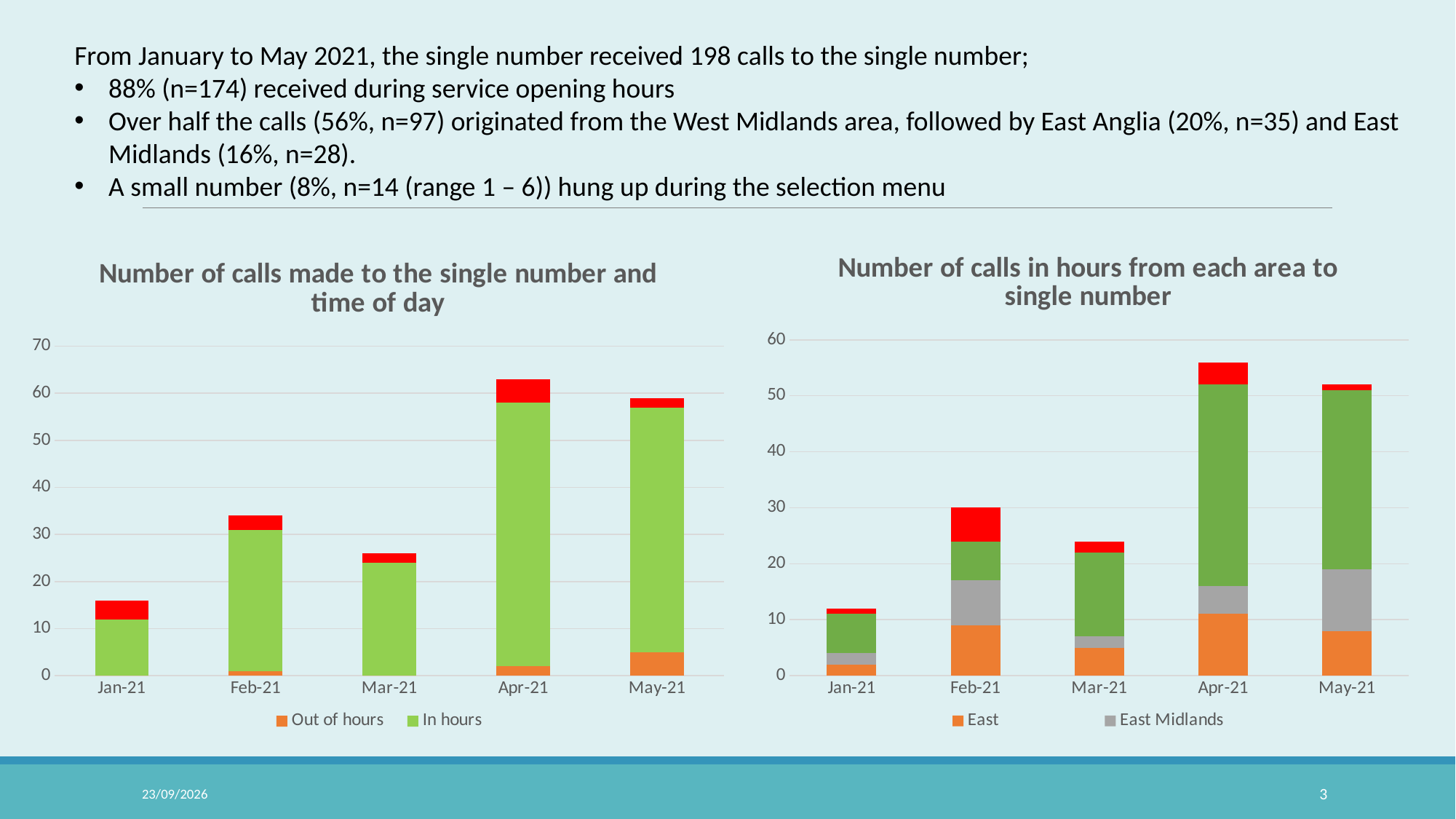
How many series does the legend list in the chart "Number of calls made to the single number and time of day"? 2 What kind of chart is the chart titled "Number of calls made to the single number and time of day"? Stacked bar chart What are the two legend entries shown for the chart "Number of calls in hours from each area to single number"? East, East Midlands In the chart "Number of calls made to the single number and time of day", how many months are shown on the x axis? 5 In the chart "Number of calls made to the single number and time of day", is the total bar height for Jan-21 greater or less than 20? less In the chart "Number of calls made to the single number and time of day", which month has the shortest bar? Jan-21 In the chart "Number of calls made to the single number and time of day", is the total bar height for Apr-21 greater or less than 60? greater In the chart "Number of calls in hours from each area to single number", is the total bar height for Apr-21 greater or less than 50? greater In the chart "Number of calls made to the single number and time of day", which month has the tallest bar? Apr-21 In the chart "Number of calls in hours from each area to single number", which month has the tallest bar? Apr-21 In the chart "Number of calls in hours from each area to single number", which bar is taller, Feb-21 or Mar-21? Feb-21 In the chart "Number of calls made to the single number and time of day", which bar is taller, Feb-21 or Mar-21? Feb-21